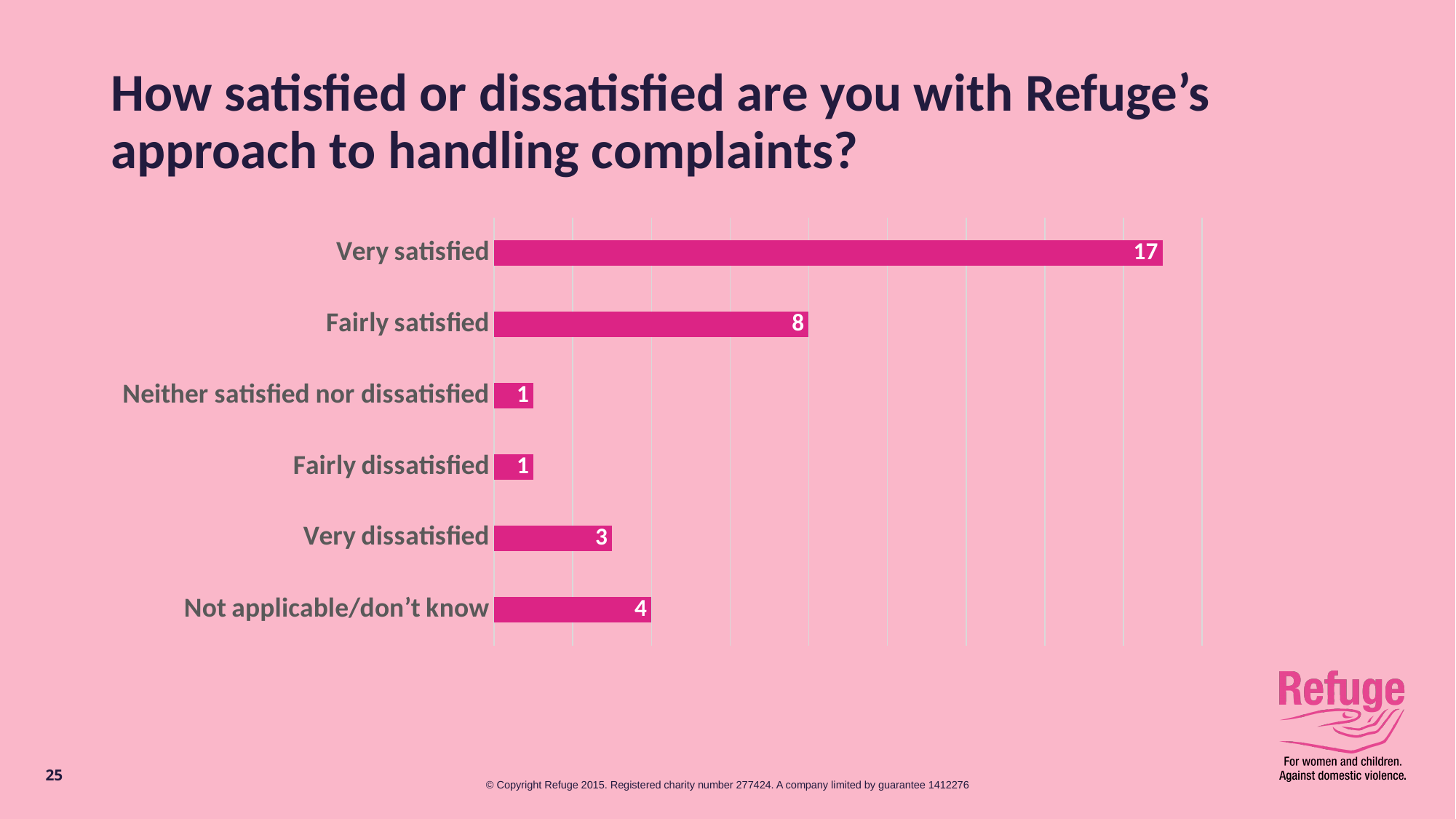
What is the value for Very satisfied? 17 Which category has the highest value? Very satisfied What is the value for Not applicable/don't know? 4 What is the title of the slide containing the chart? How satisfied or dissatisfied are you with Refuge's approach to handling complaints? What is the difference between the values for Not applicable/don't know and Very dissatisfied? 1 What is the value for Fairly dissatisfied? 1 What is the difference between the values for Very satisfied and Fairly satisfied? 9 How many categories are shown in the chart? 6 What is the value for Fairly satisfied? 8 What is the value for Very dissatisfied? 3 What kind of chart is shown on the slide? Bar chart Which is larger, the value for Very dissatisfied or the value for Not applicable/don't know? Not applicable/don't know